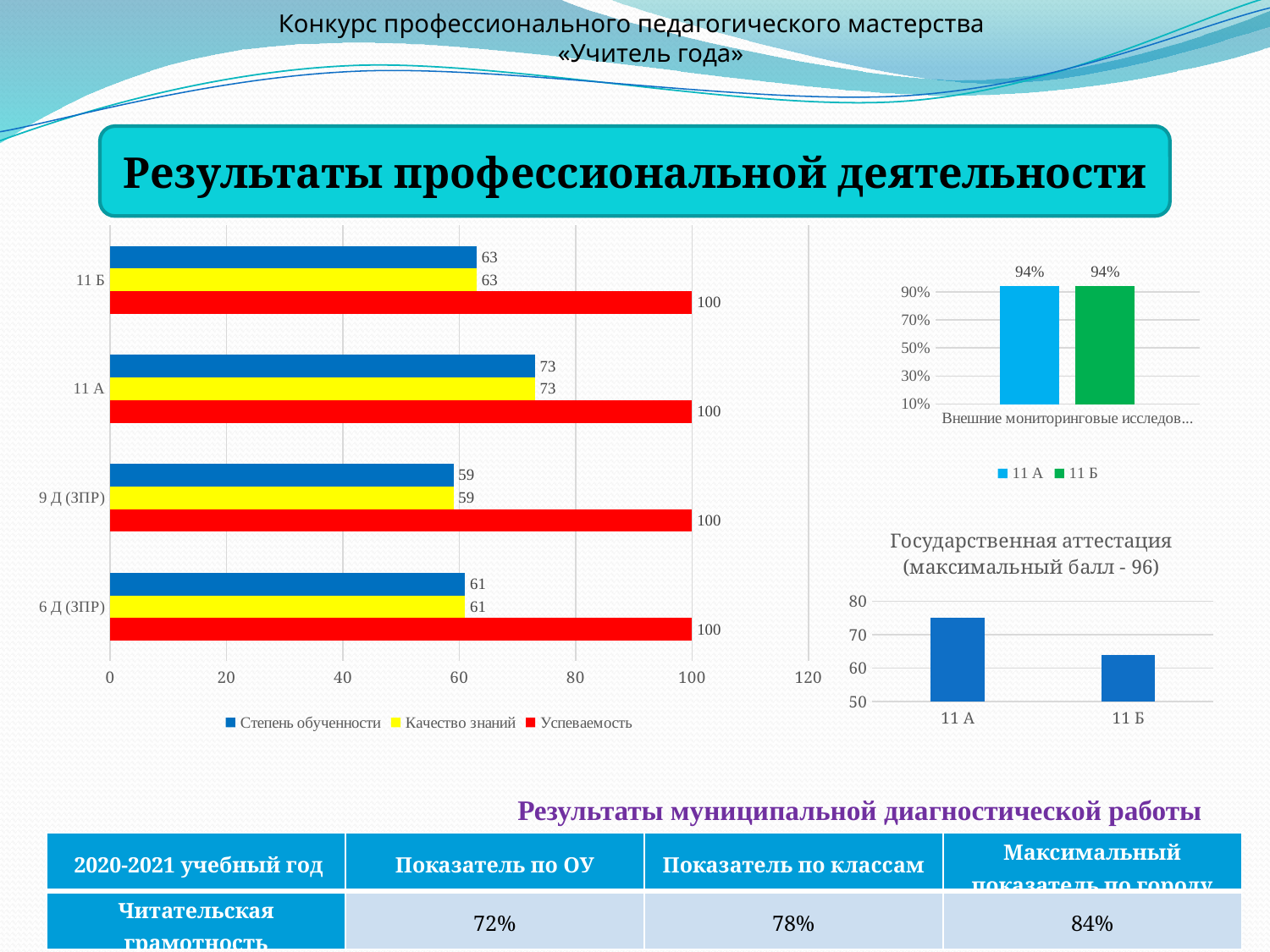
In the large horizontal bar chart on the left, what is the value of Качество знаний for 9 Д (ЗПР)? 59 What type of chart is the large chart on the left of the slide? bar chart How many classes (categories) are shown in the large horizontal bar chart on the left? 4 In the large horizontal bar chart on the left, what is the difference in Качество знаний between 11 А and 11 Б? 10 In the large horizontal bar chart on the left, which class has the highest Качество знаний? 11 А In the large horizontal bar chart on the left, what is the value of Степень обученности for 11 А? 73 In the small chart at the top right (Внешние мониторинговые исследов...), what is the value for 11 Б? 94% In the large horizontal bar chart on the left, which class has the lowest Степень обученности? 9 Д (ЗПР) How many series does the legend of the large horizontal bar chart on the left list? 3 In the large horizontal bar chart on the left, what is the value of Успеваемость for 6 Д (ЗПР)? 100 In the chart titled 'Государственная аттестация (максимальный балл - 96)', which class has the larger value, 11 А or 11 Б? 11 А In the chart titled 'Государственная аттестация (максимальный балл - 96)', is the value for 11 Б greater or less than 70? less